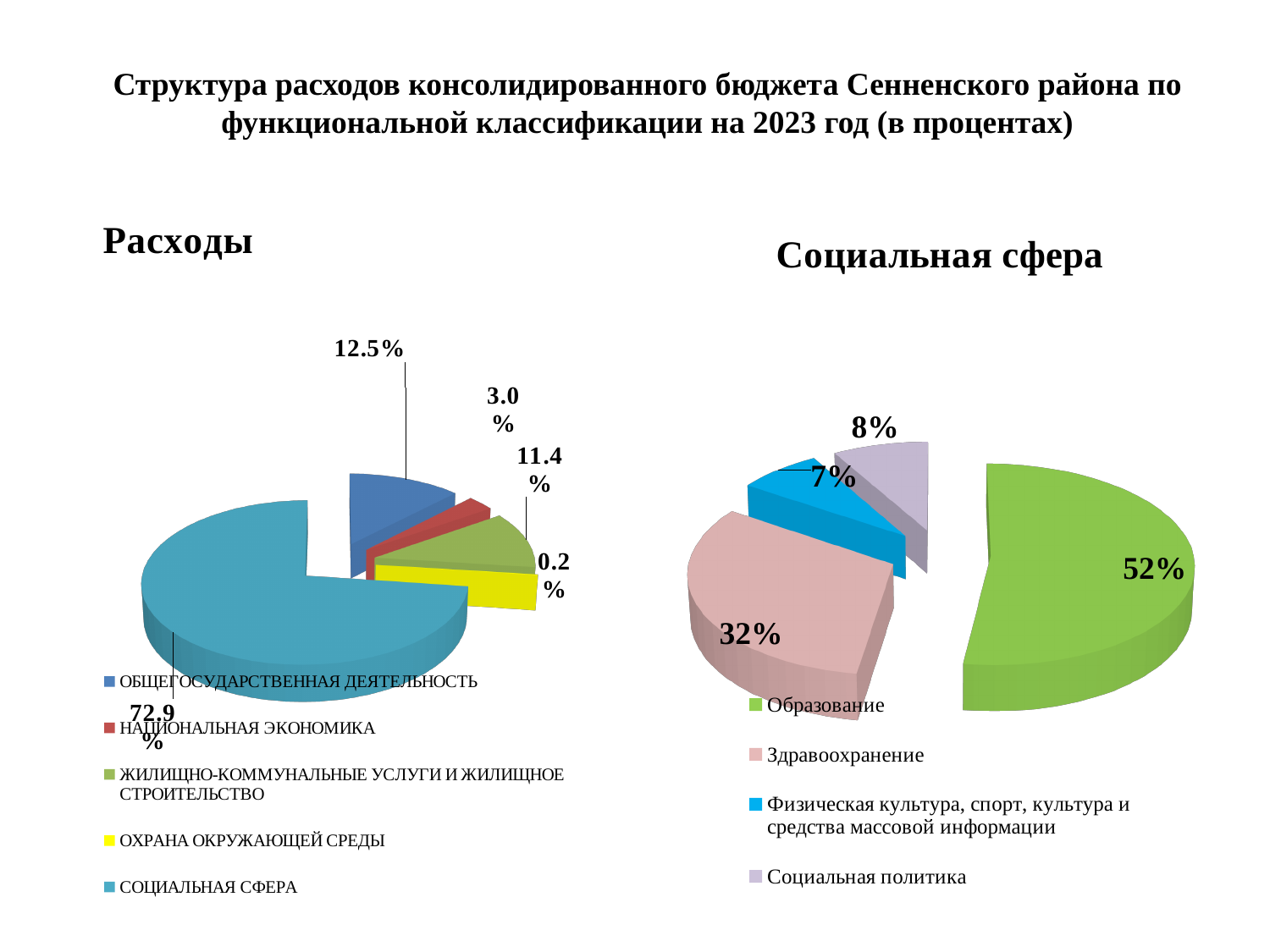
In the "Социальная сфера" chart, what share is shown for Здравоохранение? 32% In the "Расходы" chart, what share is shown for ОХРАНА ОКРУЖАЮЩЕЙ СРЕДЫ? 0.2% In the "Социальная сфера" chart, which is larger: Социальная политика or Физическая культура, спорт, культура и средства массовой информации? Социальная политика In the "Расходы" chart, how many categories does the legend list? 5 What type of chart is the "Социальная сфера" chart? Pie chart In the "Расходы" chart, what share is shown for ОБЩЕГОСУДАРСТВЕННАЯ ДЕЯТЕЛЬНОСТЬ? 12.5% In the "Расходы" chart, which category has the smallest share? ОХРАНА ОКРУЖАЮЩЕЙ СРЕДЫ In the "Социальная сфера" chart, which category has the largest share? Образование In the "Расходы" chart, what share is shown for СОЦИАЛЬНАЯ СФЕРА? 72.9% In the "Социальная сфера" chart, what colour is the Образование slice? Green In the "Социальная сфера" chart, what is the difference between the shares of Образование and Здравоохранение? 20% In the "Расходы" chart, what is the difference between the shares of ОБЩЕГОСУДАРСТВЕННАЯ ДЕЯТЕЛЬНОСТЬ and ЖИЛИЩНО-КОММУНАЛЬНЫЕ УСЛУГИ И ЖИЛИЩНОЕ СТРОИТЕЛЬСТВО? 1.1%